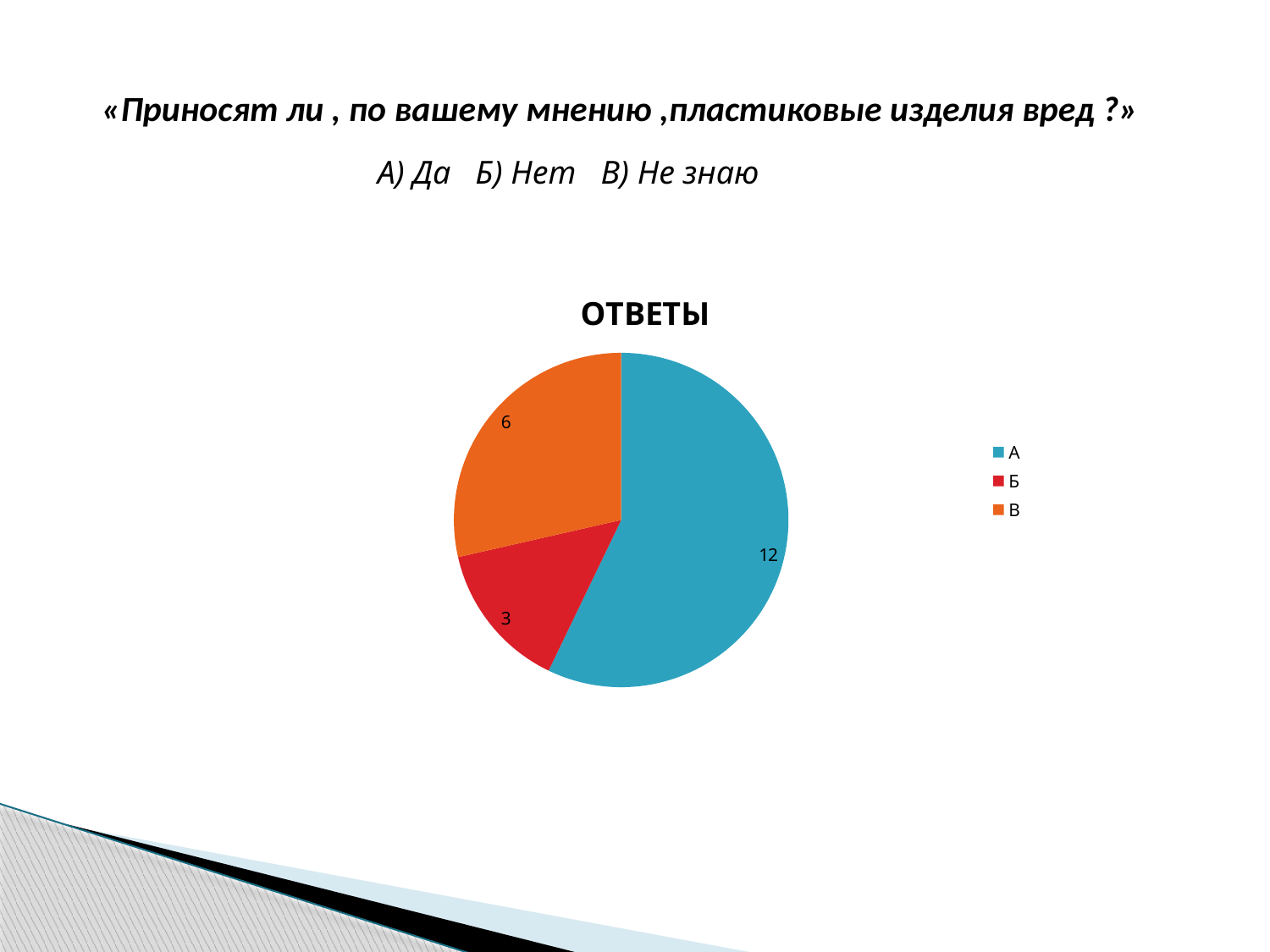
Which category has the largest slice in the pie chart? А What is the title of the chart? ОТВЕТЫ What is the difference between the values for В and Б? 3 Which category has the smallest slice in the pie chart? Б What is the difference between the values for А and В? 6 Which is larger, the value for Б or the value for В? В What is the value for category Б in the pie chart? 3 How many entries does the legend list? 3 What is the value for category В in the pie chart? 6 How many slices does the pie chart have? 3 What type of chart is shown on the slide? Pie chart What is the value for category А in the pie chart? 12